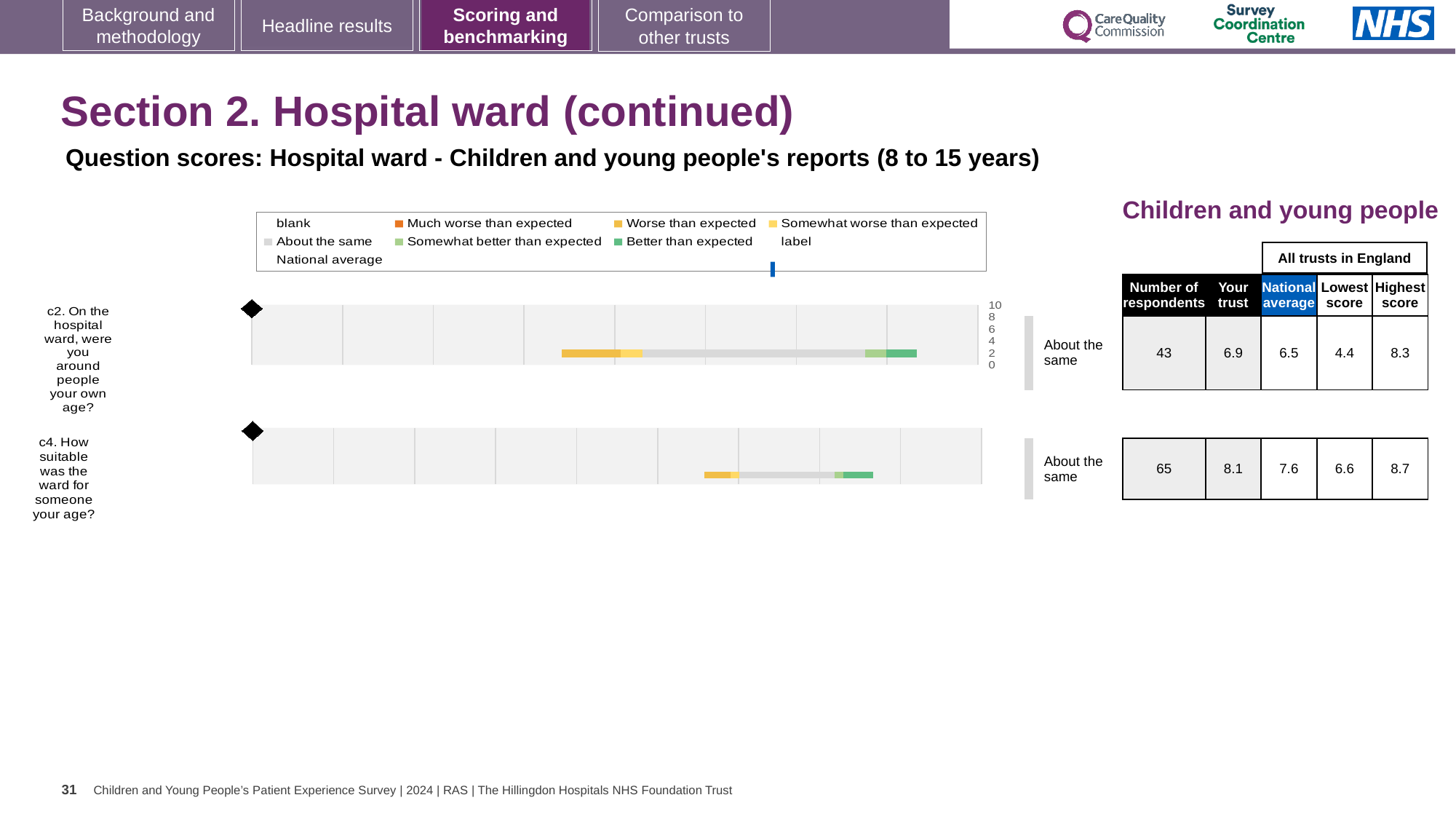
What is the difference between the trust score and the national average for c4? 0.5 What type of chart is used to show the question scores for c2 and c4? bar chart How many respondents answered question c2? 43 What is the national average score for c4 (How suitable was the ward for someone your age?)? 7.6 How many questions are plotted on the chart? 2 What is the 'Your trust' score for c2 (On the hospital ward, were you around people your own age?)? 6.9 What is the highest score across all trusts in England for c2? 8.3 Which question has the higher 'Your trust' score, c2 or c4? c4 What colour does the legend use for 'Better than expected'? green Is the trust score for c2 greater or less than 6? greater According to the legend, what does the blue marker represent? National average What is the difference between the highest and lowest scores across all trusts for c2? 3.9